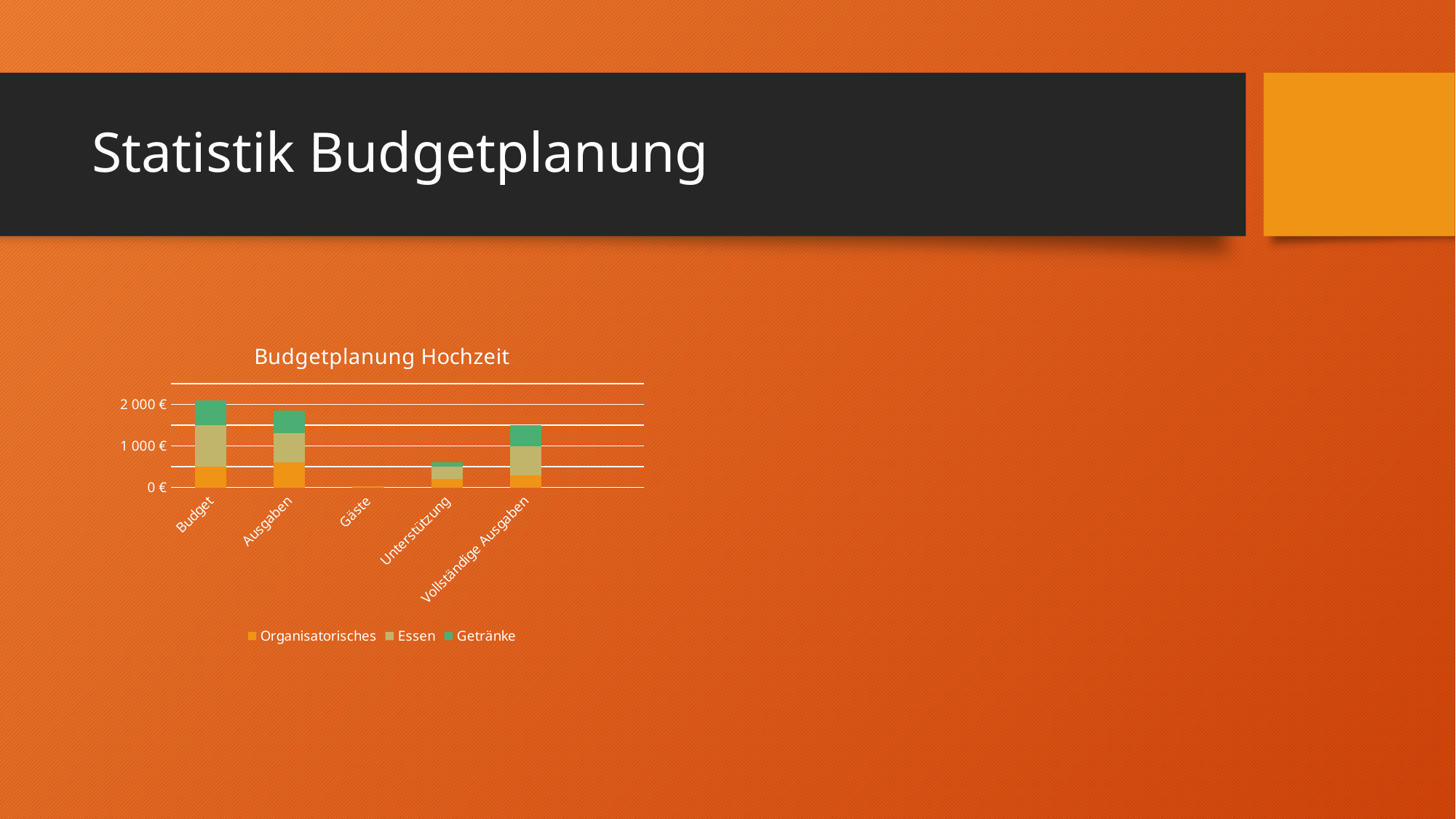
Is the total value for Vollständige Ausgaben greater or less than 1 000 €? greater How many categories are shown on the x axis of the chart? 5 Is the total value for Ausgaben greater or less than 2 000 €? less Which has the larger total stacked bar, Unterstützung or Vollständige Ausgaben? Vollständige Ausgaben Which category has the highest total stacked bar? Budget Which has the larger total stacked bar, Ausgaben or Vollständige Ausgaben? Ausgaben Which series are listed in the chart's legend? Organisatorisches, Essen, Getränke How many series does the chart's legend list? 3 Is the total value for Unterstützung greater or less than 1 000 €? less What is the title of the chart? Budgetplanung Hochzeit What kind of chart is shown on the slide? Stacked bar chart Which category has the lowest total stacked bar? Gäste